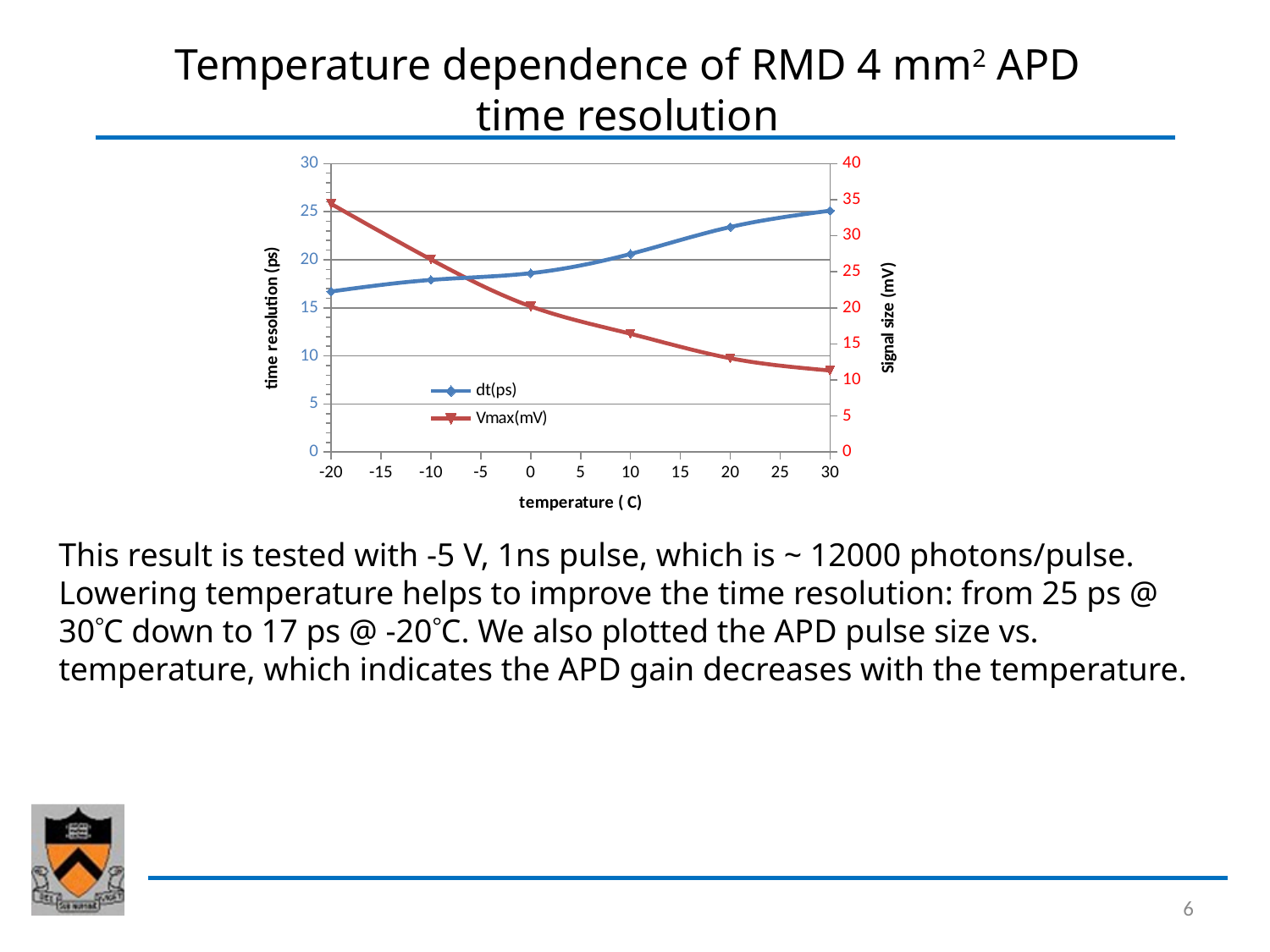
Does the Vmax(mV) series rise or fall as temperature increases along the x axis? fall What kind of chart is shown on the slide? line chart Is the Vmax(mV) value at -20 greater or less than 30? greater What is the title of the right-hand vertical axis? Signal size (mV) At which temperature is the Vmax(mV) value highest? -20 Does the dt(ps) series rise or fall as temperature increases along the x axis? rise How many series does the legend list? 2 At which temperature is the dt(ps) value highest? 30 How many temperature points are plotted for the dt(ps) series? 6 Is the Vmax(mV) value at 30 greater or less than 15? less Is the dt(ps) value at -20 greater or less than 20? less At which temperature is the Vmax(mV) value lowest? 30